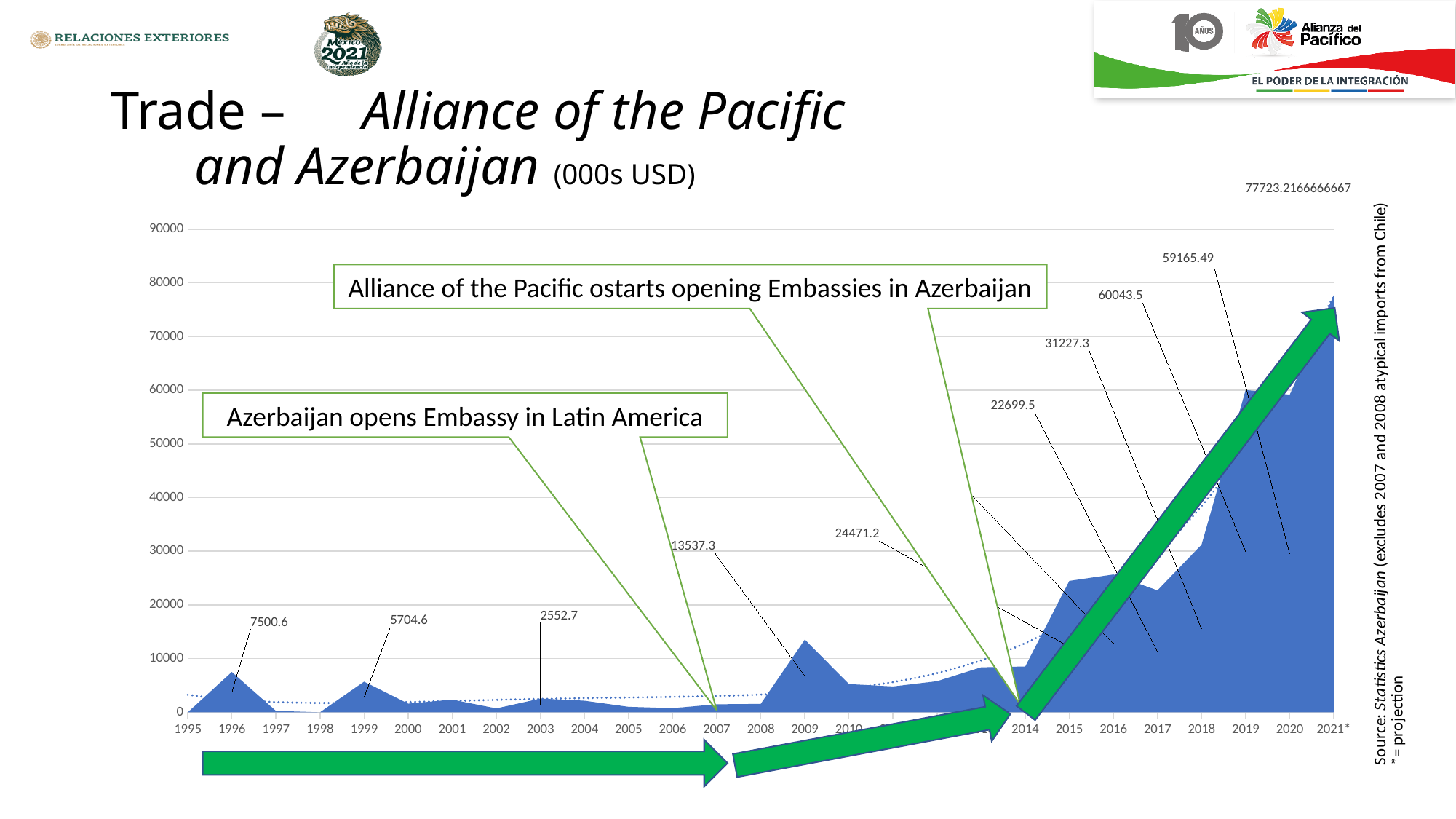
What is the data label for 1999? 5704.6 What is the data label for 2003? 2552.7 Which year has the highest value on the chart? 2021* What is the difference between the 1996 value and the 1999 value? 1796.0 In what units are the values on the chart expressed, according to the title? 000s USD Is the value for 2019 greater or less than 50000? greater What is the data label for 2009? 13537.3 What is the data label for 1996? 7500.6 Which is larger, the value for 1996 or the value for 1999? 1996 What kind of chart is shown on the slide? area chart What is the data label for 2021*? 77723.2166666667